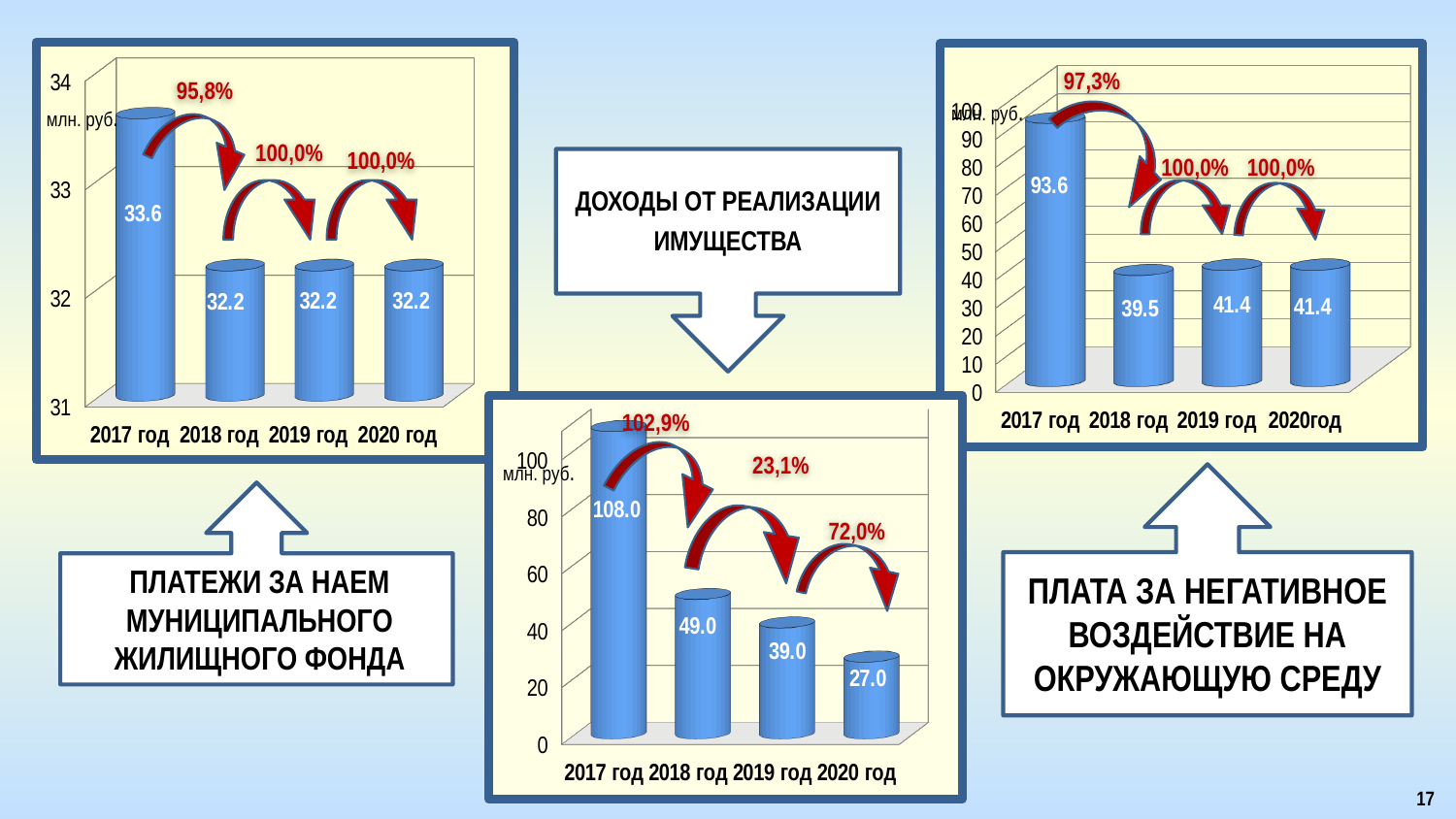
In the left chart (Платежи за наем муниципального жилищного фонда), which year has the highest value? 2017 год In the middle chart (Доходы от реализации имущества), which year has the lowest value? 2020 год In the right chart (Плата за негативное воздействие на окружающую среду), what is the value for 2017 год? 93.6 In the right chart (Плата за негативное воздействие на окружающую среду), which is larger, the value for 2018 год or 2019 год? 2019 год What kind of chart is the middle chart (Доходы от реализации имущества)? bar chart In the middle chart (Доходы от реализации имущества), what is the difference between the 2017 год and 2020 год values? 81.0 In the left chart (Платежи за наем муниципального жилищного фонда), what is the value for 2017 год? 33.6 In the middle chart (Доходы от реализации имущества), what is the value for 2018 год? 49.0 In the left chart (Платежи за наем муниципального жилищного фонда), what is the difference between the 2017 год and 2018 год values? 1.4 In the left chart (Платежи за наем муниципального жилищного фонда), what is the value for 2019 год? 32.2 How many years (categories) are shown in the right chart (Плата за негативное воздействие на окружающую среду)? 4 In the middle chart (Доходы от реализации имущества), do the values rise or fall from 2017 год to 2020 год? fall